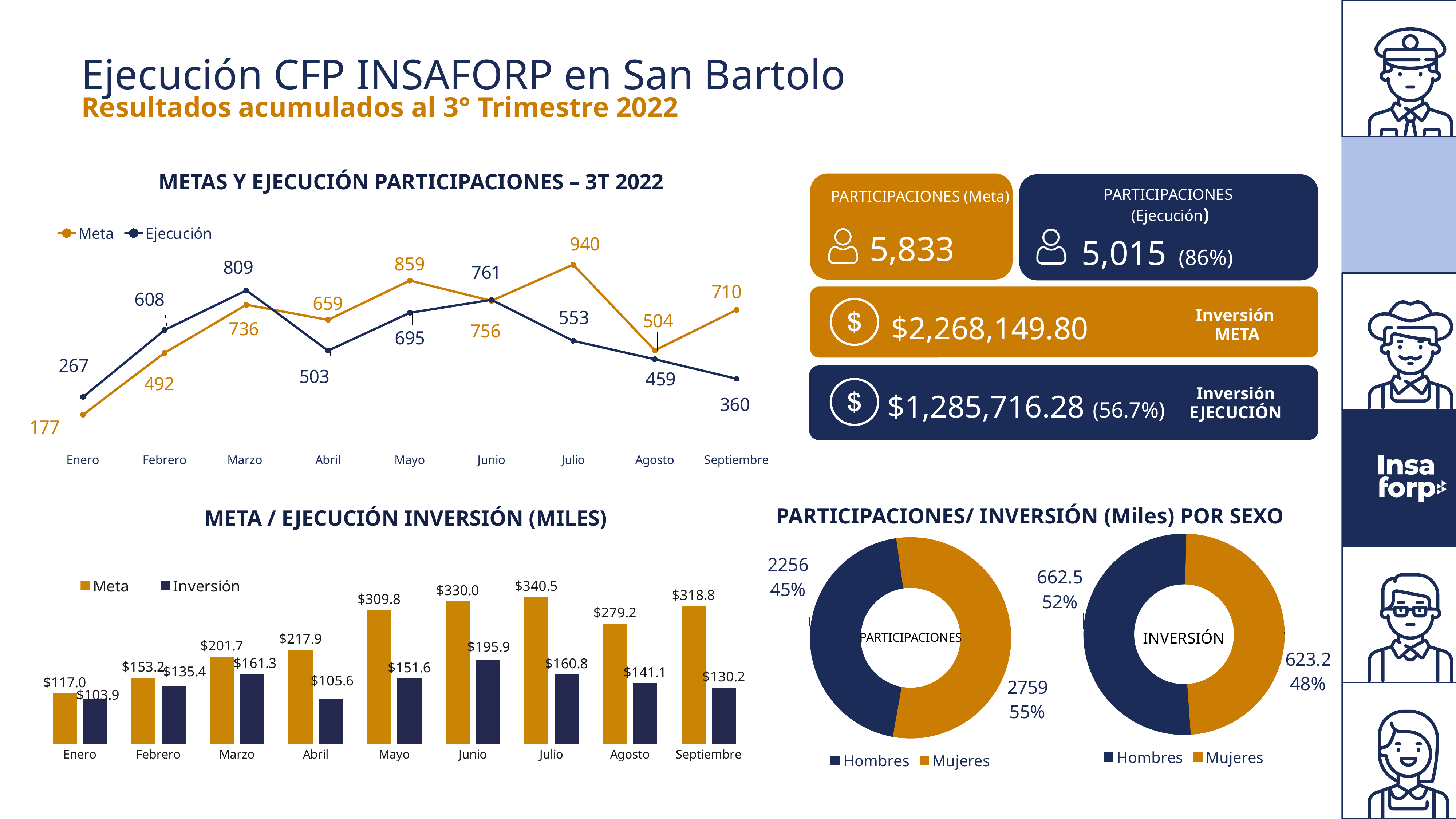
In the bar chart 'META / EJECUCIÓN INVERSIÓN (MILES)', what is the Inversión value for Junio? $195.9 In the bar chart 'META / EJECUCIÓN INVERSIÓN (MILES)', which month has the highest Meta value? Julio In the INVERSIÓN donut chart, what is the value for Hombres? 662.5 In the bar chart 'META / EJECUCIÓN INVERSIÓN (MILES)', how many series does the legend list? 2 In the line chart 'METAS Y EJECUCIÓN PARTICIPACIONES – 3T 2022', how many months are shown on the x axis? 9 What kind of chart is 'META / EJECUCIÓN INVERSIÓN (MILES)'? bar chart In the line chart 'METAS Y EJECUCIÓN PARTICIPACIONES – 3T 2022', what is the Meta value for Julio? 940 In the line chart 'METAS Y EJECUCIÓN PARTICIPACIONES – 3T 2022', which month has the lowest Meta value? Enero In the PARTICIPACIONES donut chart, what share of the total is Mujeres? 55% In the line chart 'METAS Y EJECUCIÓN PARTICIPACIONES – 3T 2022', what is the Ejecución value for Marzo? 809 In the line chart 'METAS Y EJECUCIÓN PARTICIPACIONES – 3T 2022', which month has the highest Ejecución value? Marzo In the line chart 'METAS Y EJECUCIÓN PARTICIPACIONES – 3T 2022', what is the difference between Meta and Ejecución in Julio? 387